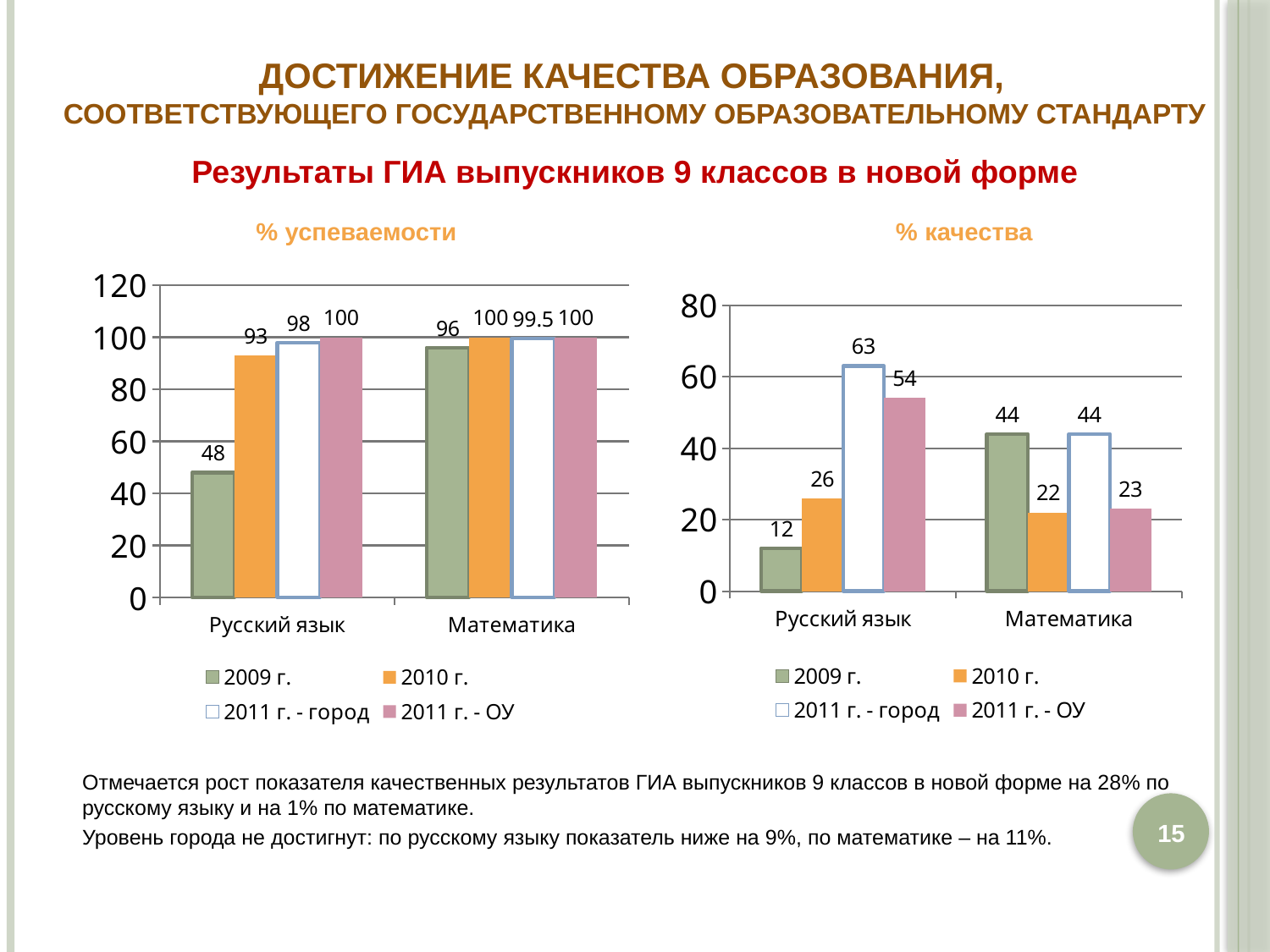
In the "% успеваемости" chart, what is the value for 2011 г. - город in Математика? 99.5 How many series does the legend of the "% качества" chart list? 4 In the "% качества" chart, what is the difference between the 2011 г. - город and 2011 г. - ОУ values for Русский язык? 9 In the "% качества" chart, what is the value for 2011 г. - ОУ in Математика? 23 How many categories are shown on the x axis of the "% успеваемости" chart? 2 In the "% качества" chart, which is larger for Математика: 2009 г. or 2010 г.? 2009 г. What kind of chart is the "% качества" chart? bar chart In the "% качества" chart, what is the highest value shown for Математика? 44 In the "% качества" chart, which series has the lowest value for Русский язык? 2009 г. In the "% успеваемости" chart, what is the difference between the 2010 г. and 2009 г. values for Русский язык? 45 In the "% успеваемости" chart, what is the value for 2009 г. in Русский язык? 48 In the "% качества" chart, what is the value for 2011 г. - город in Русский язык? 63